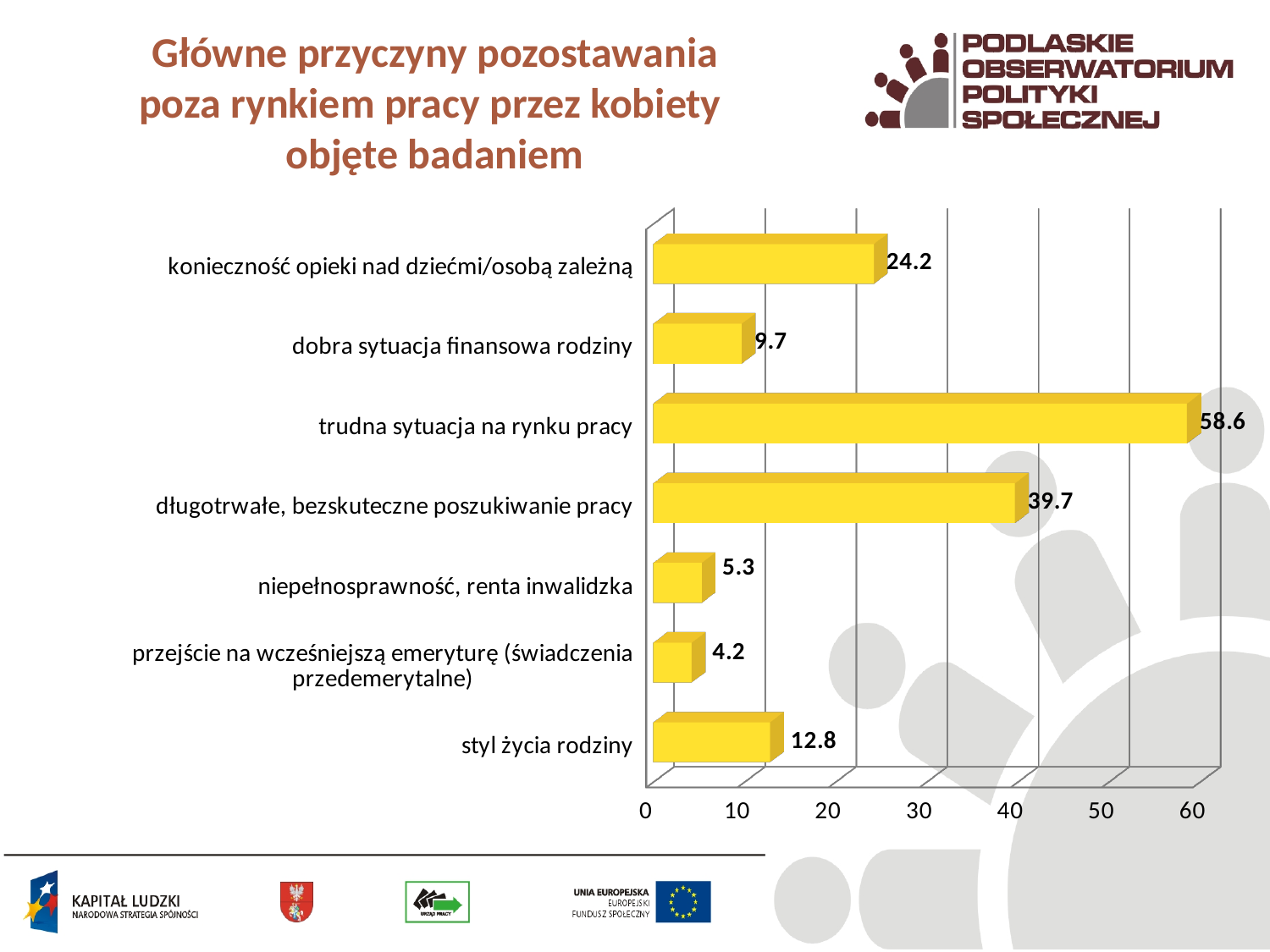
What is the value for "konieczność opieki nad dziećmi/osobą zależną"? 24.2 Is the value for "długotrwałe, bezskuteczne poszukiwanie pracy" greater or less than 30? greater How many categories are shown in the chart? 7 What is the value for "trudna sytuacja na rynku pracy"? 58.6 What is the difference between the values for "trudna sytuacja na rynku pracy" and "długotrwałe, bezskuteczne poszukiwanie pracy"? 18.9 What is the value for "styl życia rodziny"? 12.8 What is the value for "niepełnosprawność, renta inwalidzka"? 5.3 What is the title of the slide? Główne przyczyny pozostawania poza rynkiem pracy przez kobiety objęte badaniem Which category has the lowest value? przejście na wcześniejszą emeryturę (świadczenia przedemerytalne) What kind of chart is shown on the slide? bar chart Which category has the highest value? trudna sytuacja na rynku pracy Which is larger: the value for "dobra sytuacja finansowa rodziny" or the value for "styl życia rodziny"? styl życia rodziny